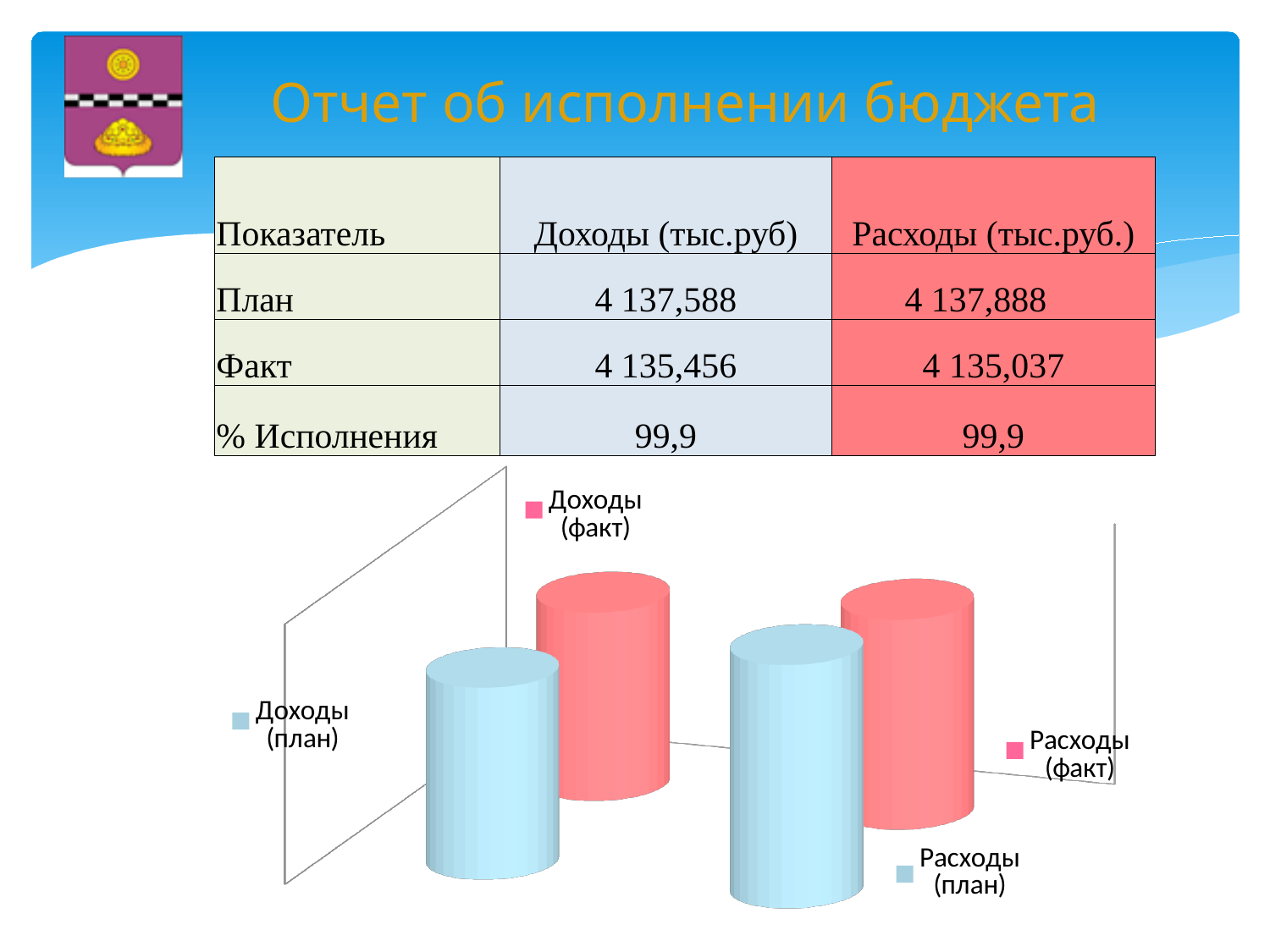
According to the table on the slide, which is larger: the План for Доходы or the План for Расходы? Расходы (4 137,888) What is the title of the slide containing the chart? Отчет об исполнении бюджета What kind of chart is shown on the slide? bar chart What colour are the Доходы (план) and Расходы (план) bars in the chart? light blue How many bars are plotted in the chart? 4 According to the table on the slide, what is the planned value (План) for Доходы (тыс.руб)? 4 137,588 According to the table on the slide, what is the actual value (Факт) for Расходы (тыс.руб.)? 4 135,037 According to the table on the slide, what is the % Исполнения for Доходы? 99,9